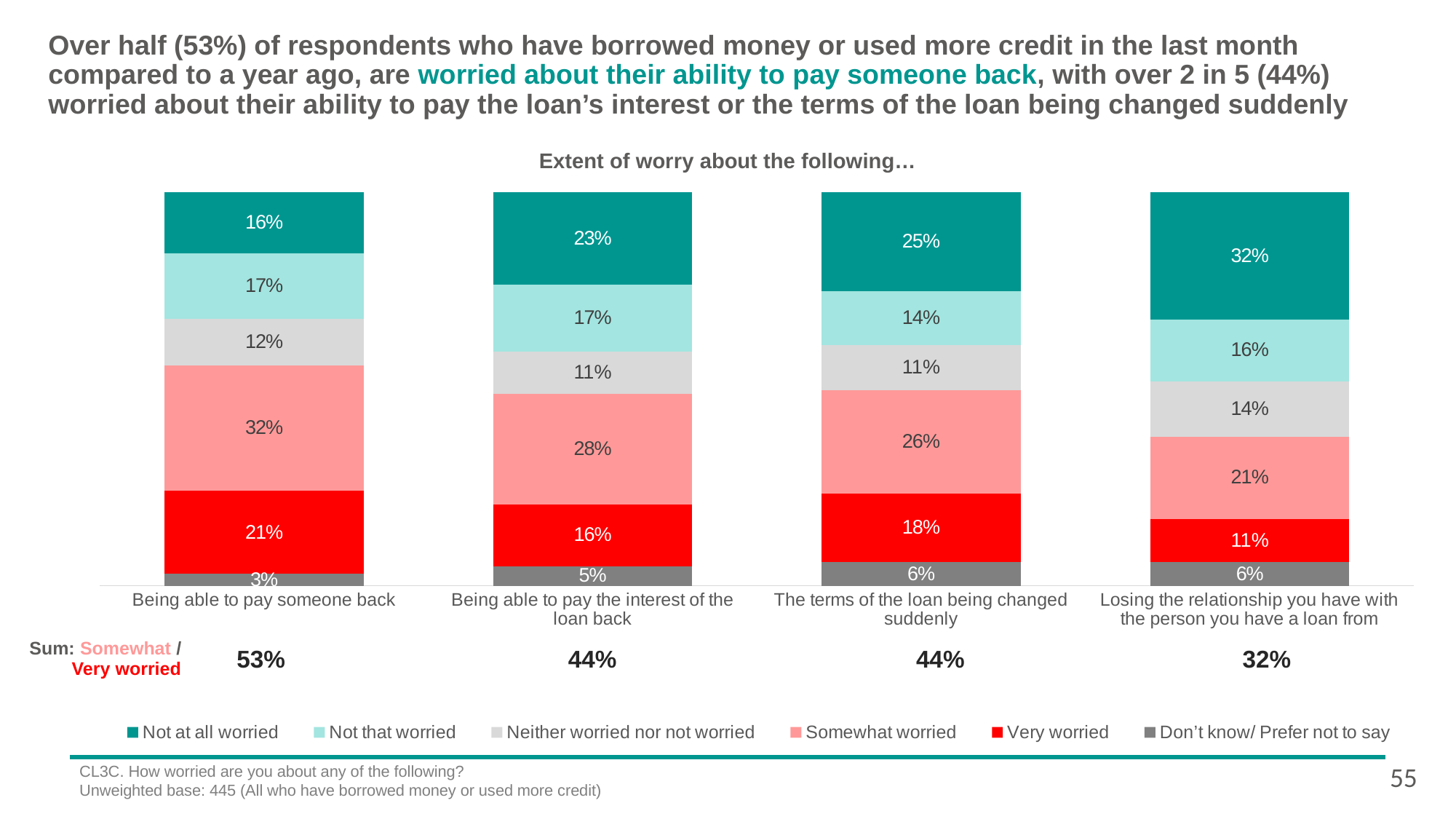
Which category has the lowest 'Very worried' percentage? Losing the relationship you have with the person you have a loan from Which has a higher 'Very worried' percentage: the terms of the loan being changed suddenly, or being able to pay the interest of the loan back? The terms of the loan being changed suddenly What is the difference in the 'Somewhat worried' percentage between being able to pay someone back and losing the relationship with the person you have a loan from? 11 percentage points What is the combined 'Somewhat worried / Very worried' sum shown for the terms of the loan being changed suddenly? 44% What percentage of respondents answered 'Don't know/ Prefer not to say' for being able to pay the interest of the loan back? 5% How many series does the legend list? 6 What percentage of respondents are 'Not at all worried' about losing the relationship they have with the person they have a loan from? 32% What percentage of respondents are 'Very worried' about being able to pay someone back? 21% Which category has the highest 'Not at all worried' percentage? Losing the relationship you have with the person you have a loan from What kind of chart is shown on the slide? Stacked bar chart What is the title of the chart? Extent of worry about the following… How many categories (bars) are shown in the chart? 4